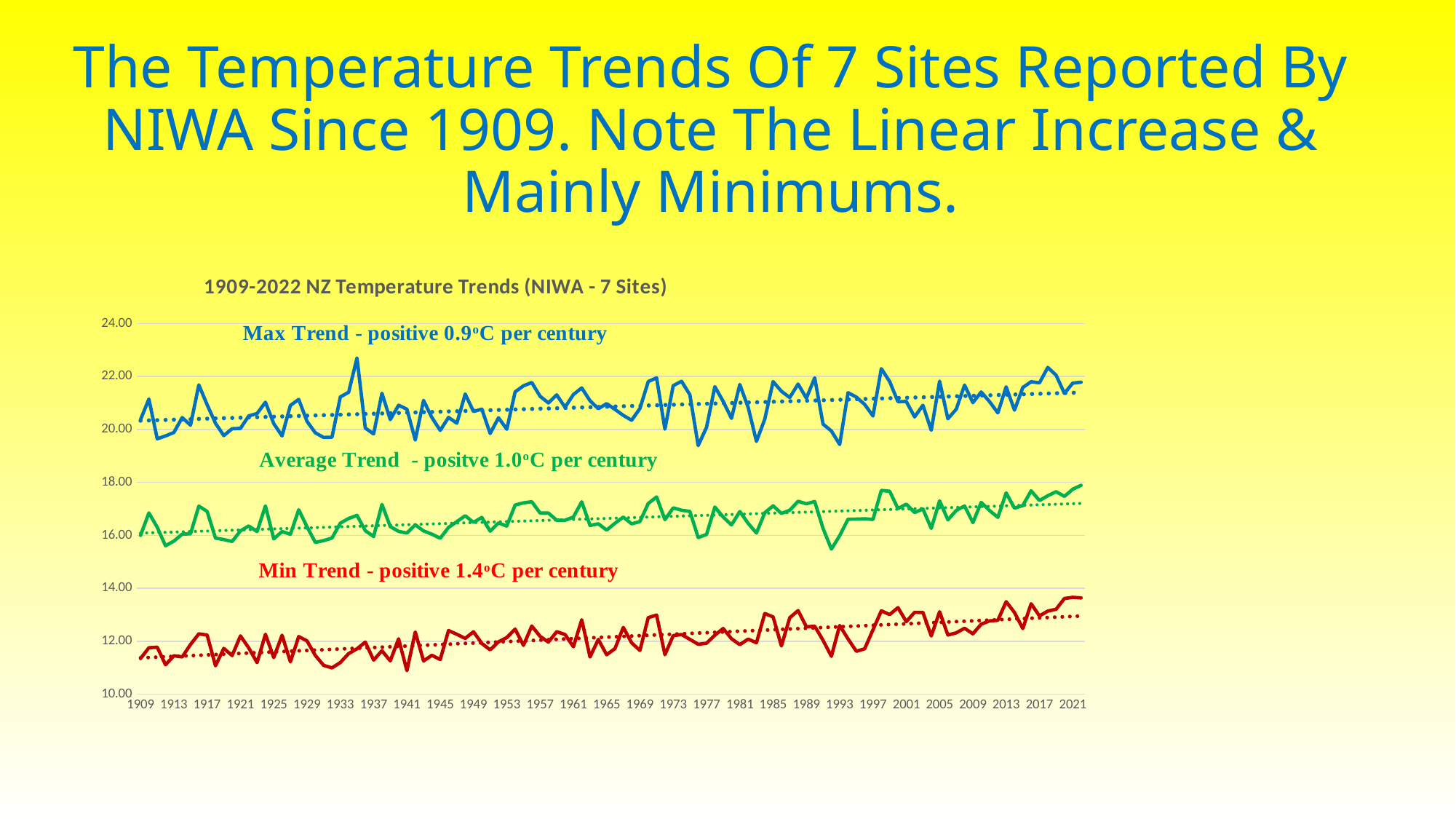
What type of chart is shown on the slide? line chart Is the Average (green) value around 1993 greater or less than 16.00? less According to the annotation on the chart, what is the Average Trend per century? positive 1.0°C per century Is the Max (blue) value around 1935 greater or less than 22.00? greater What is the title of the chart? 1909-2022 NZ Temperature Trends (NIWA - 7 Sites) What colour is the line representing the Min temperature series? red According to the annotation on the chart, what is the Max Trend per century? positive 0.9°C per century According to the annotation on the chart, what is the Min Trend per century? positive 1.4°C per century Which of the three trends (Max, Average, Min) has the smallest increase per century? Max Trend Which of the three trends (Max, Average, Min) has the largest increase per century? Min Trend Is the Min (red) value in 1909 greater or less than 12.00? less Do the temperature series generally rise or fall from 1909 to 2021? rise